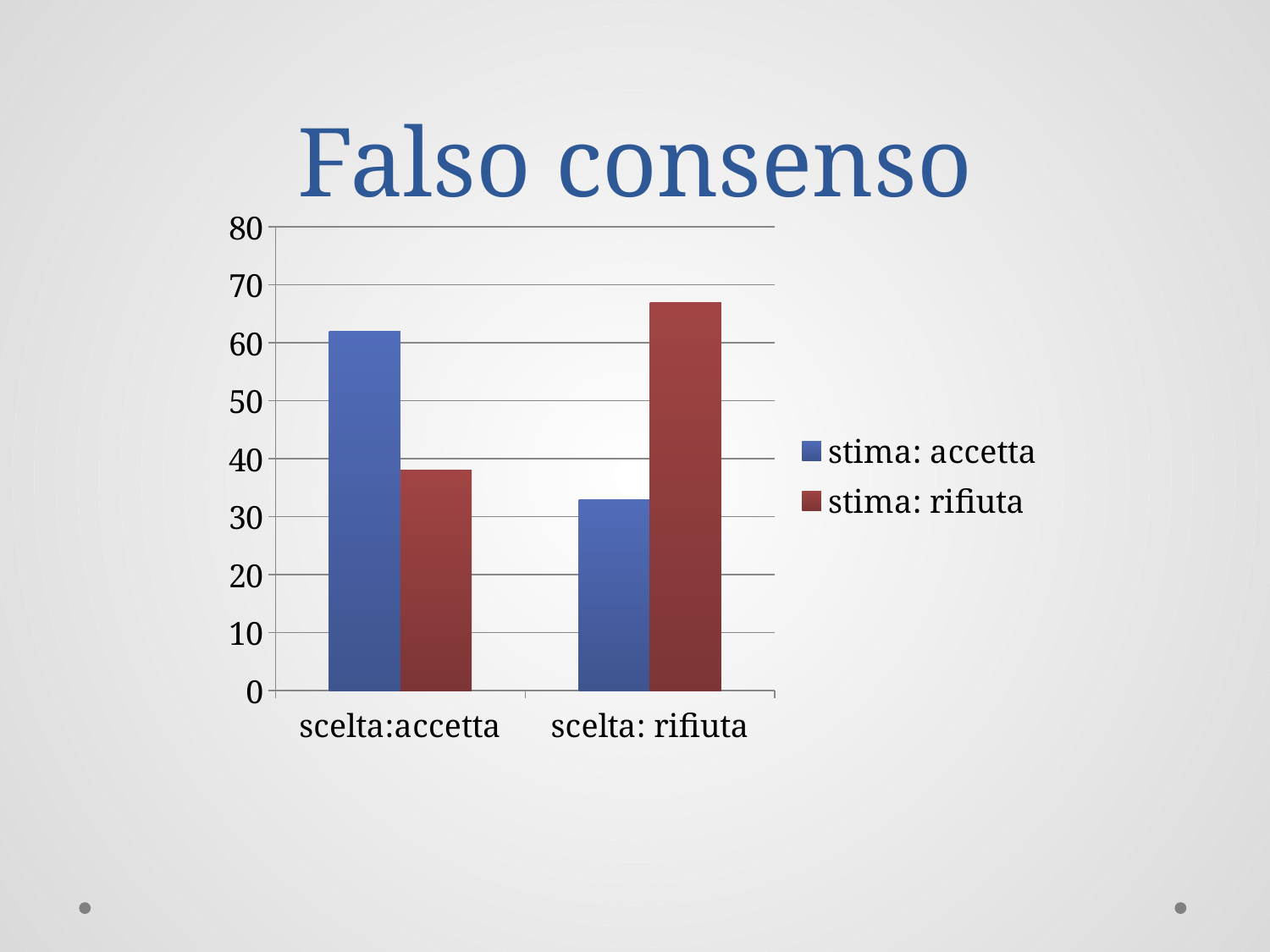
What kind of chart is shown on the slide? bar chart Which series is shown in red? stima: rifiuta Is the value for 'stima: accetta' in the 'scelta: rifiuta' category greater or less than 30? greater In the 'scelta:accetta' category, which series has the larger value, 'stima: accetta' or 'stima: rifiuta'? stima: accetta What is the title of the slide containing the chart? Falso consenso Is the value for 'stima: rifiuta' in the 'scelta: rifiuta' category greater or less than 60? greater Which bar is the tallest in the chart? stima: rifiuta in scelta: rifiuta Is the value for 'stima: accetta' in the 'scelta:accetta' category greater or less than 60? greater How many series does the legend list? 2 In the 'scelta: rifiuta' category, which series has the larger value, 'stima: accetta' or 'stima: rifiuta'? stima: rifiuta How many categories are shown on the x axis? 2